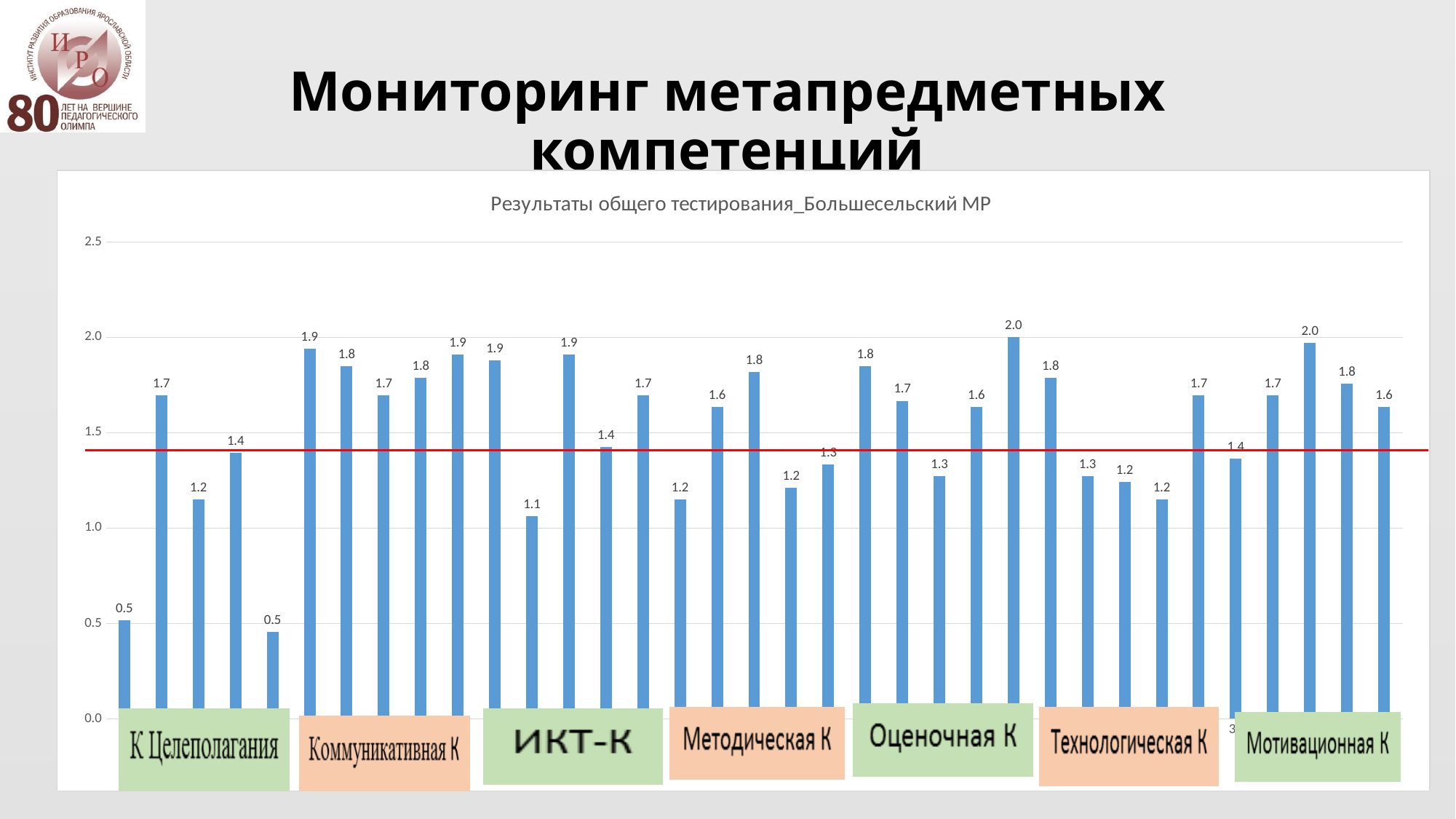
What is the highest value among the bars in the Оценочная К group? 2.0 What kind of chart is shown on the slide? bar chart What is the highest value shown by any bar in the chart? 2.0 What is the lowest value shown by any bar in the chart? 0.5 Is the value of the first bar in the К Целеполагания group greater or less than 1.0? less What is the value of the first bar in the Коммуникативная К group? 1.9 Which is larger: the first bar of the Коммуникативная К group or the first bar of the Методическая К group? Коммуникативная К How many bars are plotted in the chart in total? 35 What is the lowest value among the bars in the ИКТ-К group? 1.1 In the Методическая К group, what is the difference between the highest bar (1.8) and the lowest bar (1.2)? 0.6 How many competency groups are labelled along the bottom of the chart? 7 What is the title of the chart? Результаты общего тестирования_Большесельский МР